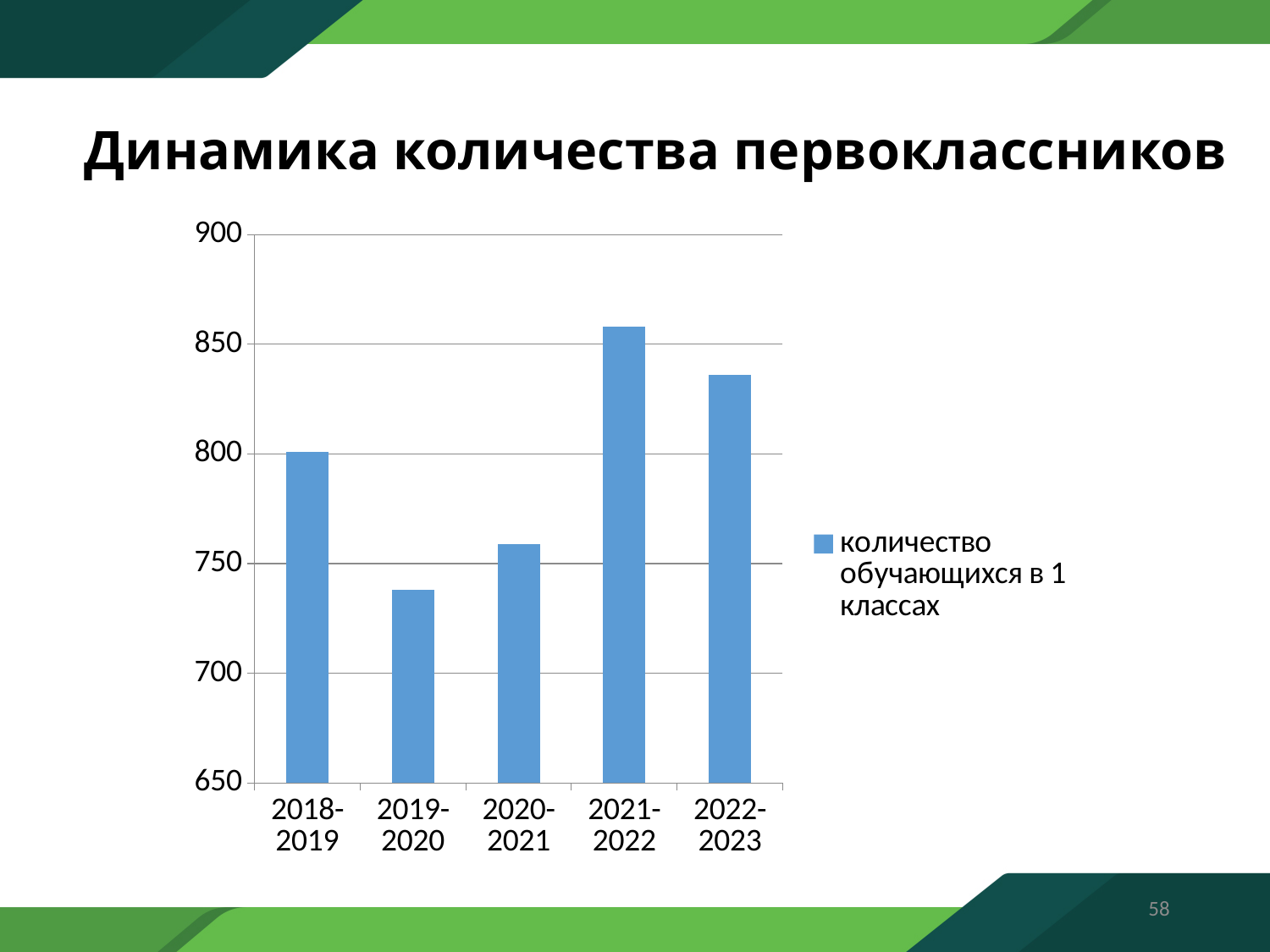
How many school years are shown on the x axis? 5 Is the value for 2019-2020 greater or less than 750? less Is the value for 2022-2023 greater or less than 850? less What is the legend entry for the series? количество обучающихся в 1 классах Which school year has the highest number of first-graders? 2021-2022 Which is larger, the value for 2021-2022 or the value for 2022-2023? 2021-2022 Is the value for 2018-2019 greater or less than 750? greater How many series does the legend list? 1 What type of chart is shown on the slide? bar chart Which school year has the lowest number of first-graders? 2019-2020 What is the title of the slide with the chart? Динамика количества первоклассников